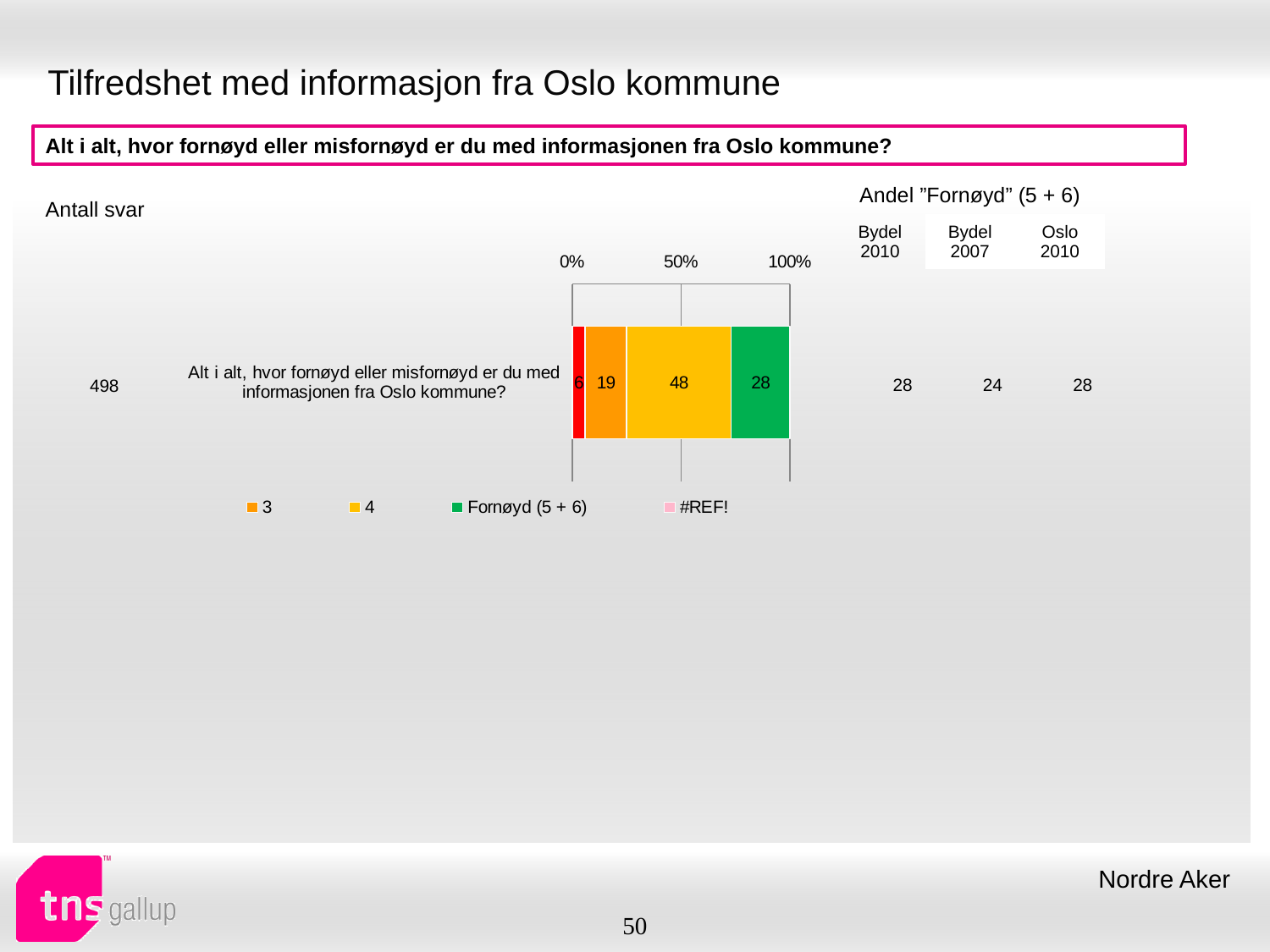
Which is larger, the "4" segment or the "Fornøyd (5 + 6)" segment? 4 How many bars does the chart contain? 1 What is the value of the "4" segment in the stacked bar? 48 What is the difference between the "4" segment and the "3" segment? 29 What is the difference between the "4" segment and the "Fornøyd (5 + 6)" segment? 20 What is the value of the "Fornøyd (5 + 6)" segment in the stacked bar? 28 What is the number of responses (Antall svar) shown for the question? 498 What colour is the "Fornøyd (5 + 6)" segment? Green Which legend series has the largest segment in the bar? 4 How many entries does the legend list? 4 What is the value of the "3" segment in the stacked bar? 19 What kind of chart is shown on the slide? Stacked bar chart